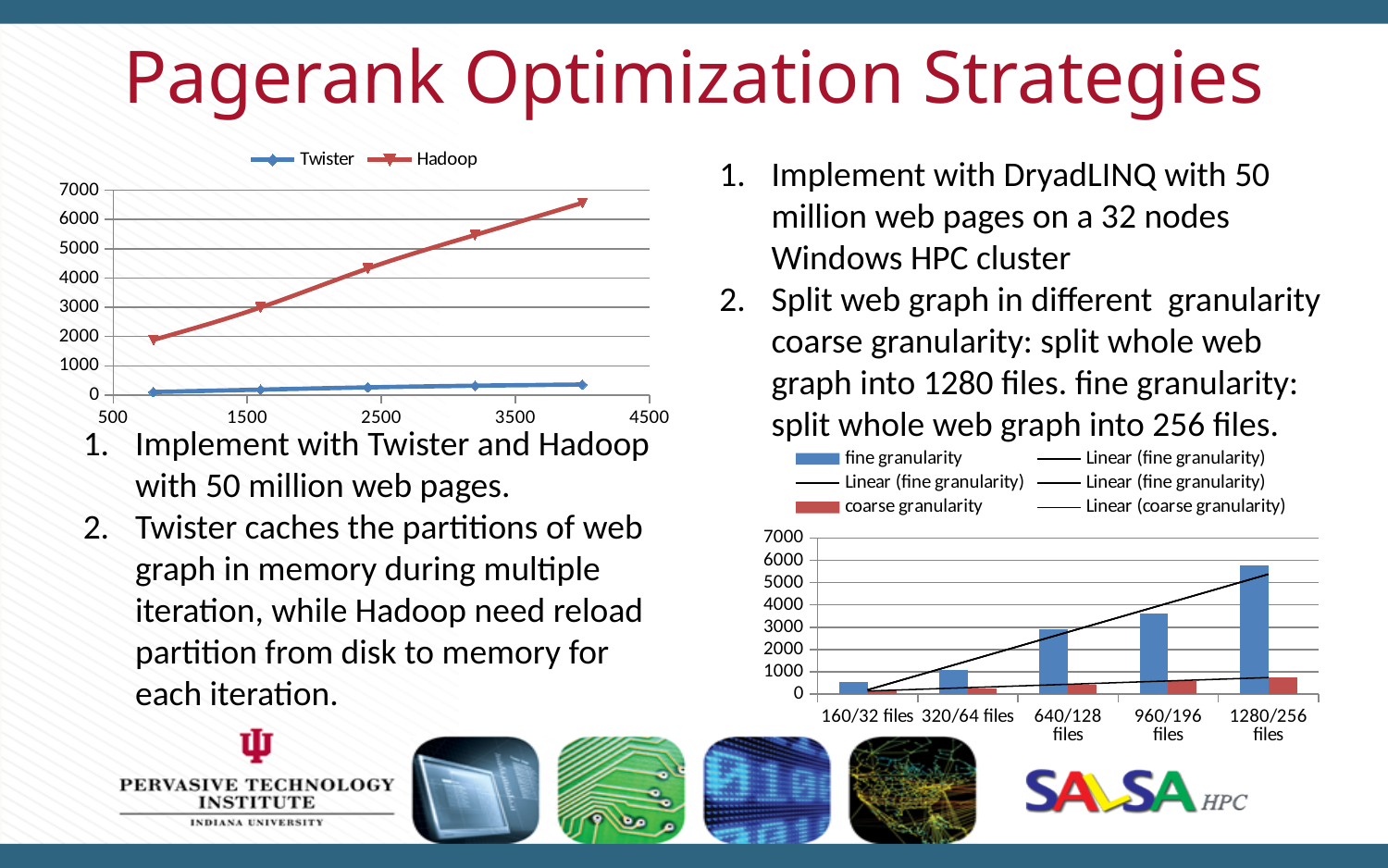
What type of chart is the chart on the left of the slide (Twister vs Hadoop)? line chart In the right chart, is the fine granularity value for 1280/256 files greater or less than 5000? greater In the left chart, is the highest Hadoop value greater or less than 6000? greater In the left chart, are all the Twister values greater or less than 1000? less In the left chart, does the Hadoop line rise or fall as the x-axis value increases? rise In the right chart, how many entries does the legend list? 6 What type of chart is the chart on the right of the slide (fine vs coarse granularity)? bar chart In the right chart, how many categories are shown on the x-axis? 5 In the left chart, which series has the higher values, Twister or Hadoop? Hadoop In the right chart, which series has the taller bars, fine granularity or coarse granularity? fine granularity In the right chart, which category has the highest fine granularity bar? 1280/256 files In the left chart, how many series does the legend list? 2